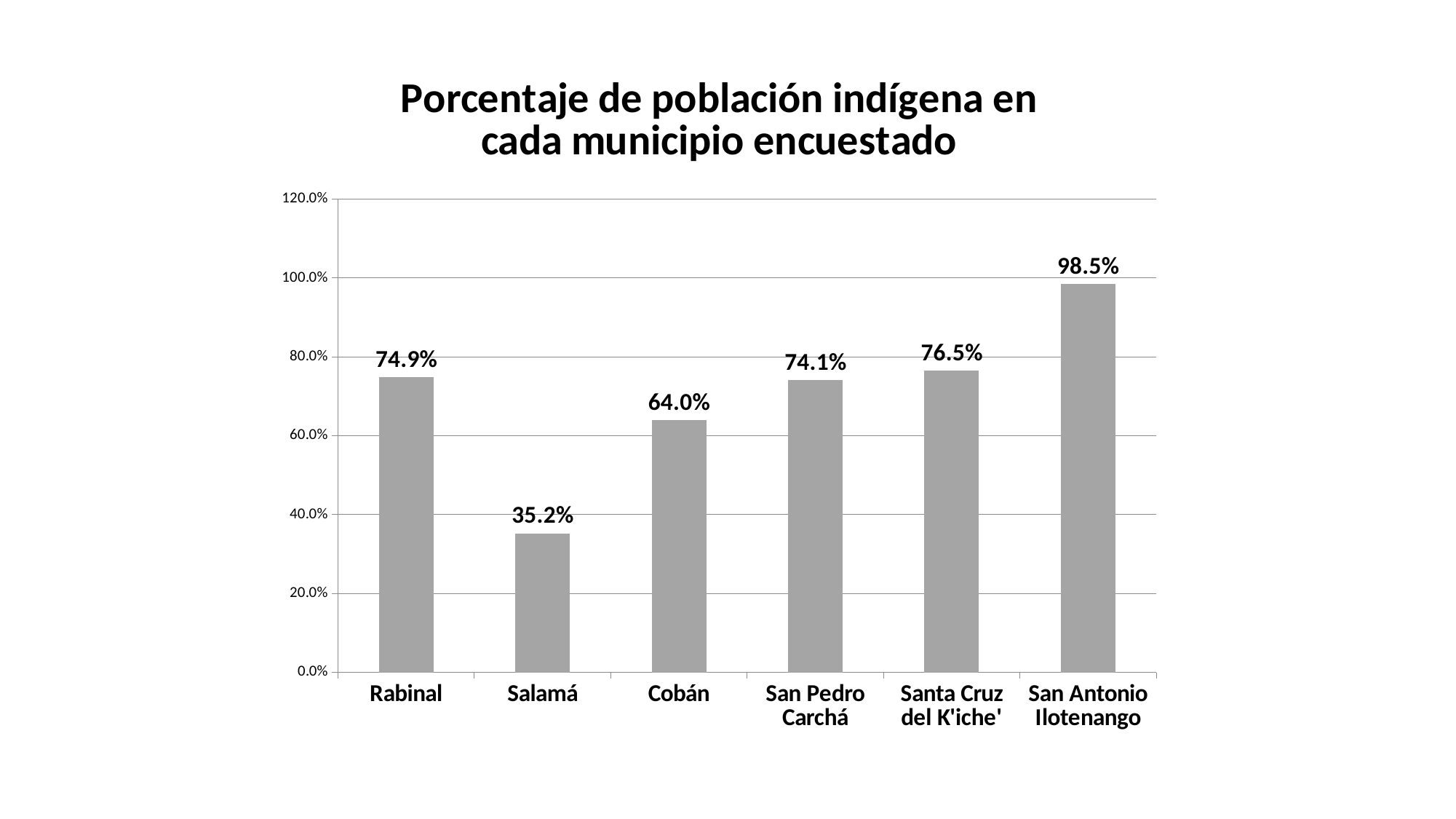
What is the value for Cobán? 64.0% What is the title of the chart? Porcentaje de población indígena en cada municipio encuestado How many municipalities are shown in the chart? 6 What is the value for Rabinal? 74.9% Which is larger, the value for Cobán or the value for Santa Cruz del K'iche'? Santa Cruz del K'iche' What kind of chart is shown on the slide? Bar chart What is the value for Salamá? 35.2% Which municipality has the lowest percentage of indigenous population? Salamá Which municipality has the highest percentage of indigenous population? San Antonio Ilotenango What is the difference between the values for San Antonio Ilotenango and Salamá? 63.3% What is the value for San Antonio Ilotenango? 98.5% Is the value for Salamá greater or less than 40.0%? less